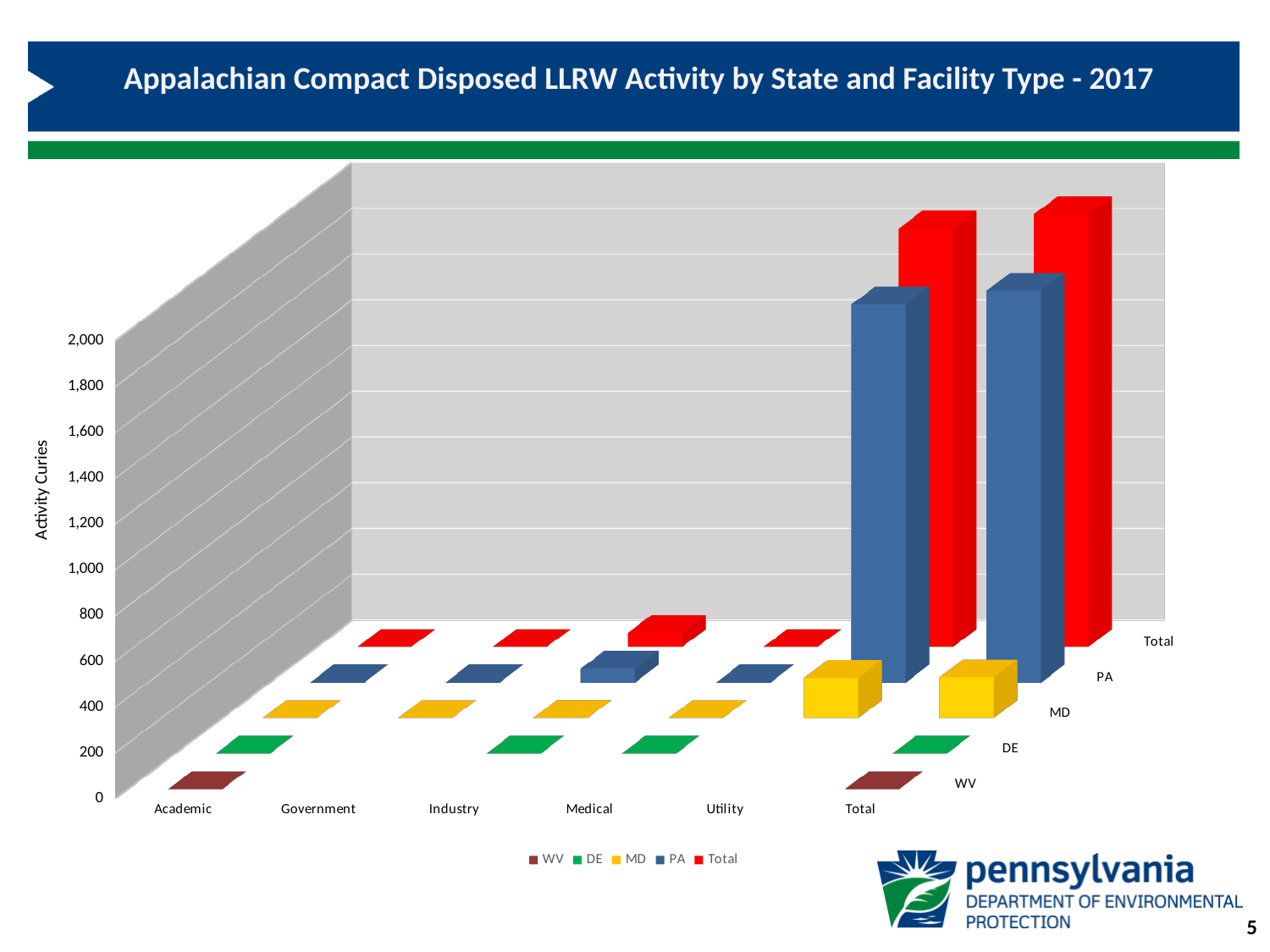
Is the Total series value for the Total category greater or less than 1,000? greater Is the MD value for Utility greater or less than 400? less Is the PA value for Utility greater or less than 1,000? greater What kind of chart is shown on the slide? bar chart Excluding the Total category, which facility type has the highest PA value? Utility What is the title of the chart? Appalachian Compact Disposed LLRW Activity by State and Facility Type - 2017 What is the label of the vertical axis? Activity Curies How many facility type categories are shown on the x axis? 6 How many series does the legend list? 5 Which is larger, the PA value for Utility or the PA value for Medical? Utility Which series has the highest value in the Utility category? Total